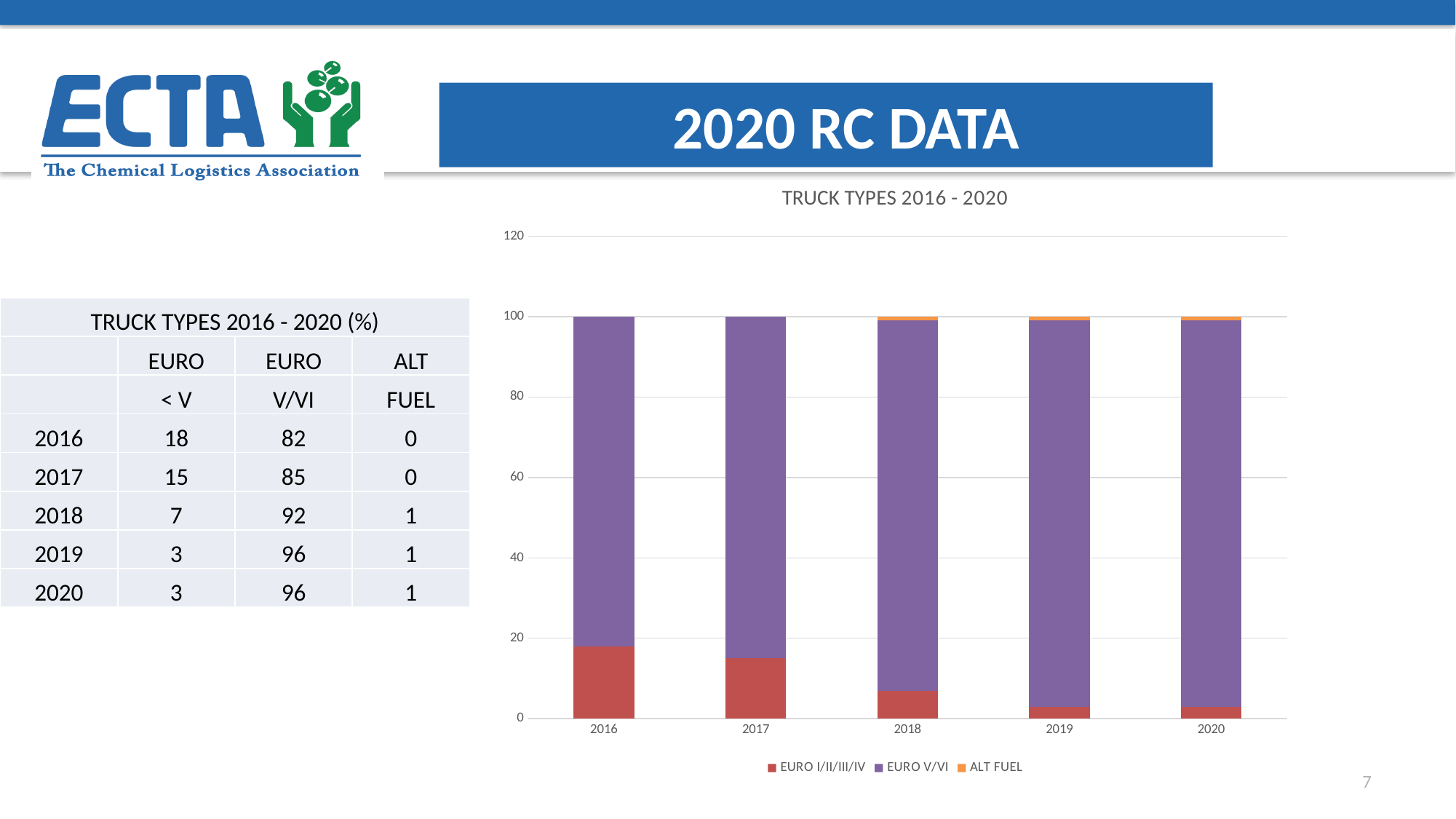
Is the EURO I/II/III/IV value for 2016 greater or less than 20? less According to the table, what is the EURO < V value for 2016? 18 How many series does the chart legend list? 3 What is the difference between the EURO V/VI values for 2020 and 2016? 14 Does the EURO V/VI share rise or fall from 2016 to 2020? Rise What type of chart is shown on the slide? Stacked bar chart According to the table, what is the EURO V/VI value for 2018? 92 How many years are shown on the x axis of the chart? 5 Is the EURO I/II/III/IV value for 2017 larger or smaller than for 2018? Larger Which year has the lowest EURO V/VI share? 2016 What is the title of the chart? TRUCK TYPES 2016 - 2020 Which year has the highest EURO I/II/III/IV (EURO < V) share? 2016